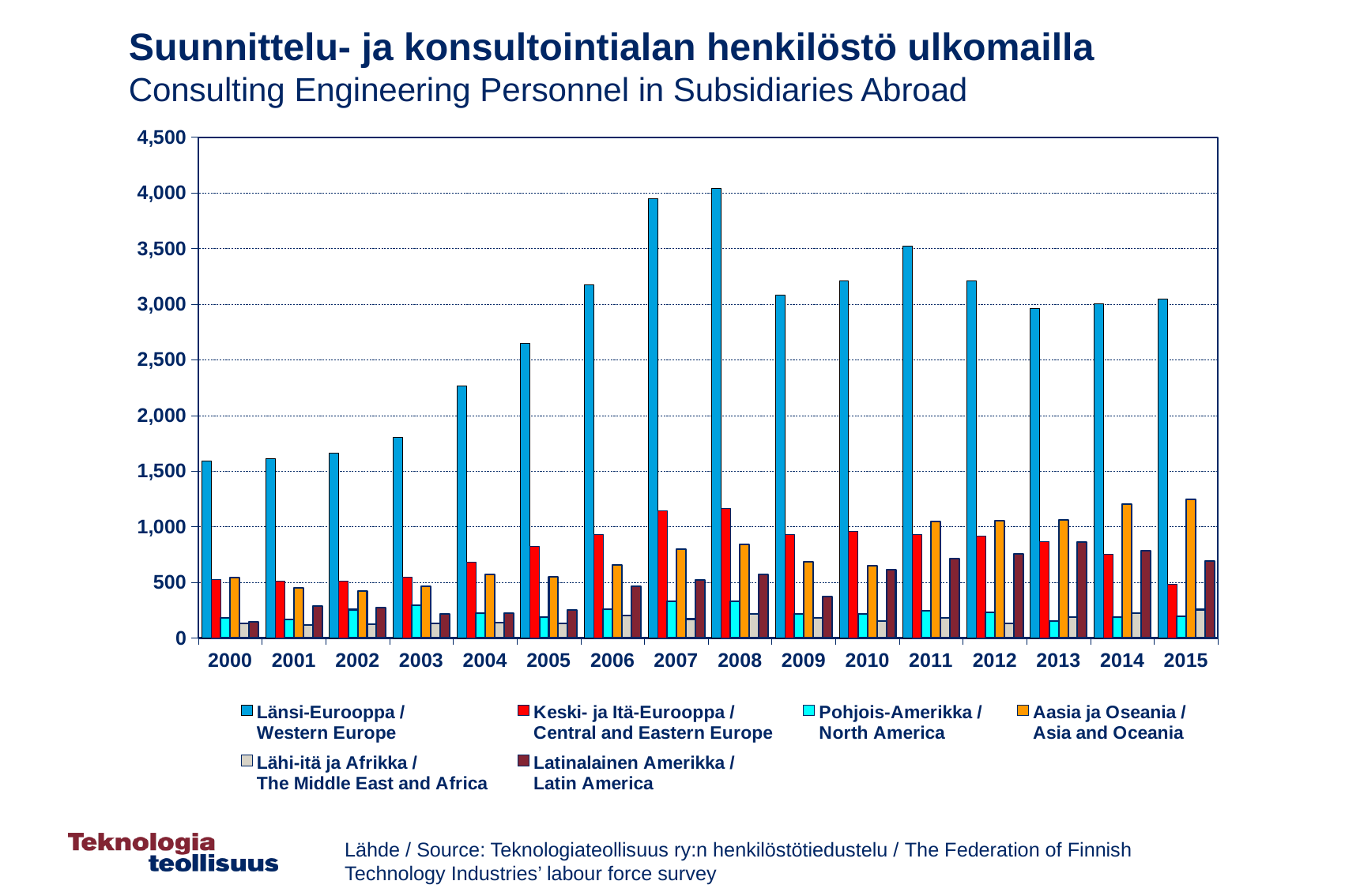
What kind of chart is shown on the slide? bar chart How many series does the legend list? 6 In which year is the value for Western Europe highest? 2008 Is the value for Western Europe in 2005 greater or less than 2,500? greater Do the values for Western Europe rise or fall from 2000 to 2008? rise Which is larger, the value for Western Europe in 2007 or in 2009? 2007 Which is larger in 2015, the value for Asia and Oceania or for Central and Eastern Europe? Asia and Oceania What is the English title of the chart? Consulting Engineering Personnel in Subsidiaries Abroad Is the value for Western Europe in 2008 greater or less than 4,000? greater Is the value for North America in 2008 greater or less than 500? less How many years are shown on the x axis? 16